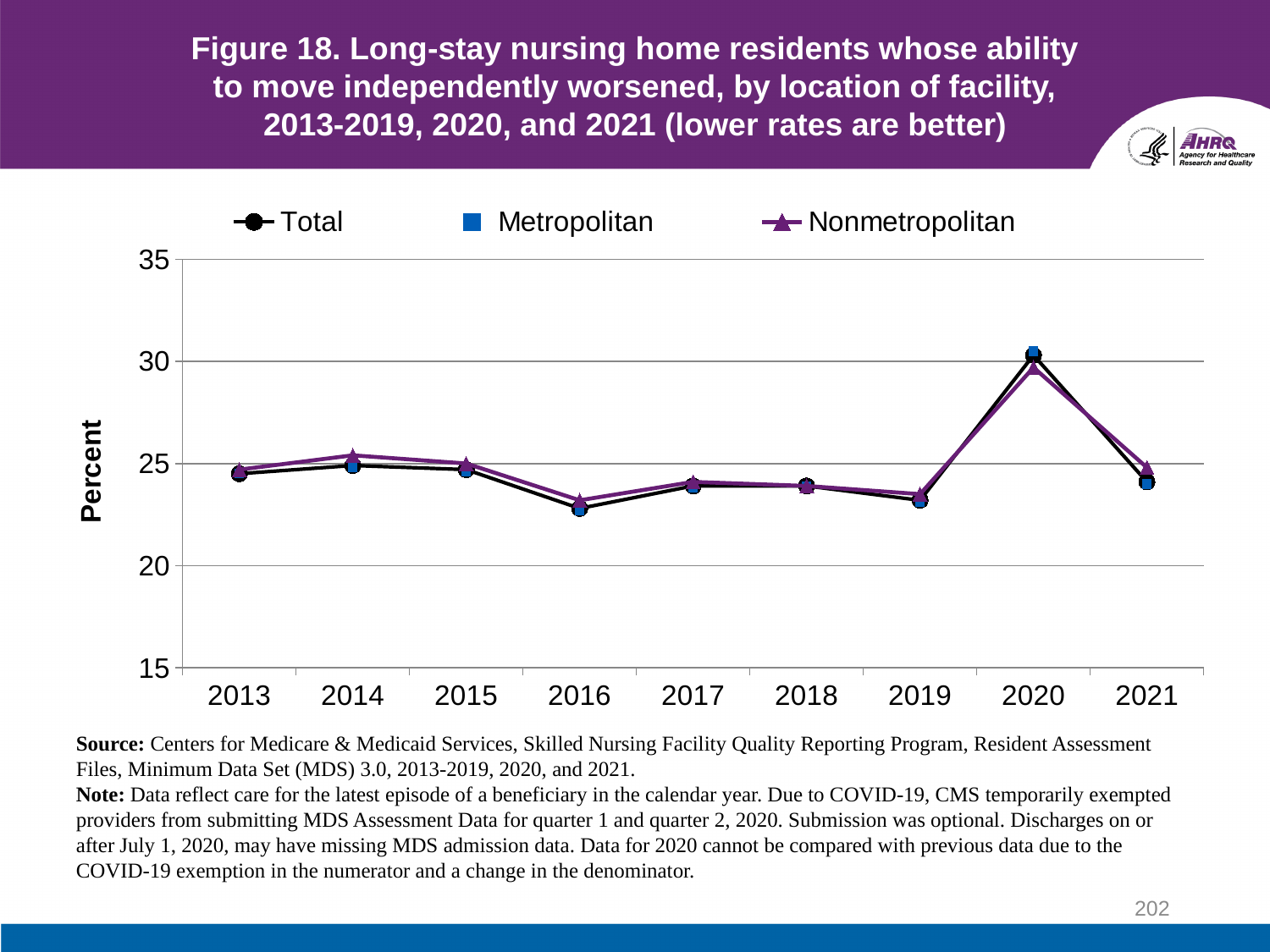
How many years are plotted along the x axis? 9 What kind of chart is shown on the slide? Line chart Do the Total values rise or fall from 2020 to 2021? fall Is the Total value for 2016 greater or less than 25? less Which is larger for the Total series, the value for 2020 or the value for 2021? 2020 How many series does the legend list? 3 In which year is the Total value highest? 2020 Is the Total value for 2020 greater or less than 25? greater Is the Nonmetropolitan value for 2019 greater or less than 25? less What are the three series named in the legend? Total, Metropolitan, Nonmetropolitan What is the label on the y axis? Percent